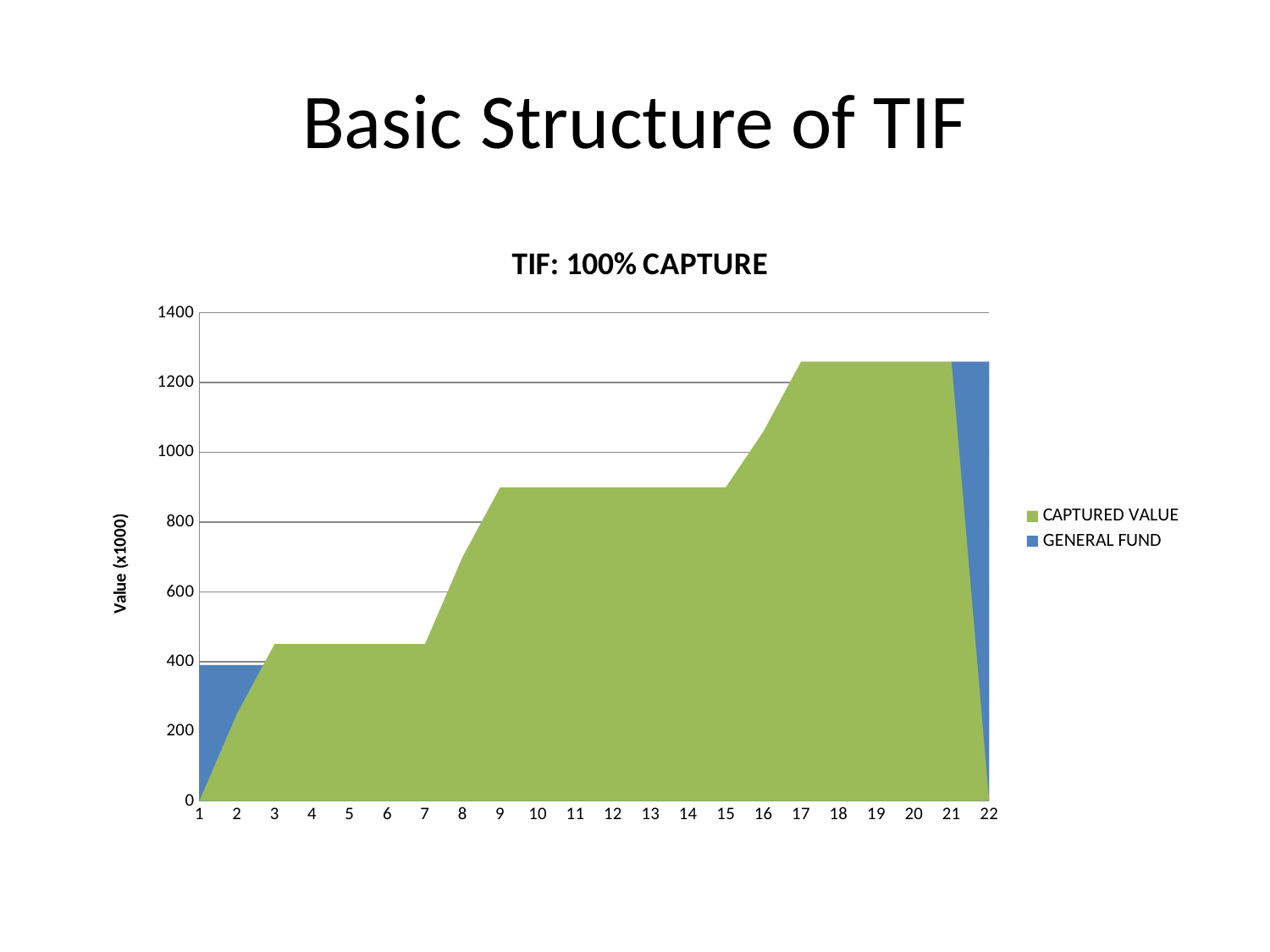
Does the CAPTURED VALUE rise or fall from point 1 to point 17? rise Is the CAPTURED VALUE at point 19 greater or less than 1200? greater Is the CAPTURED VALUE at point 2 greater or less than 400? less What kind of chart is shown on the slide? Area chart How many series does the legend list? 2 Which is larger, the CAPTURED VALUE at point 18 or at point 4? point 18 Which series is shown in green? CAPTURED VALUE What is the title of the chart? TIF: 100% CAPTURE Is the CAPTURED VALUE at point 5 greater or less than 600? less How many points are plotted along the x axis? 22